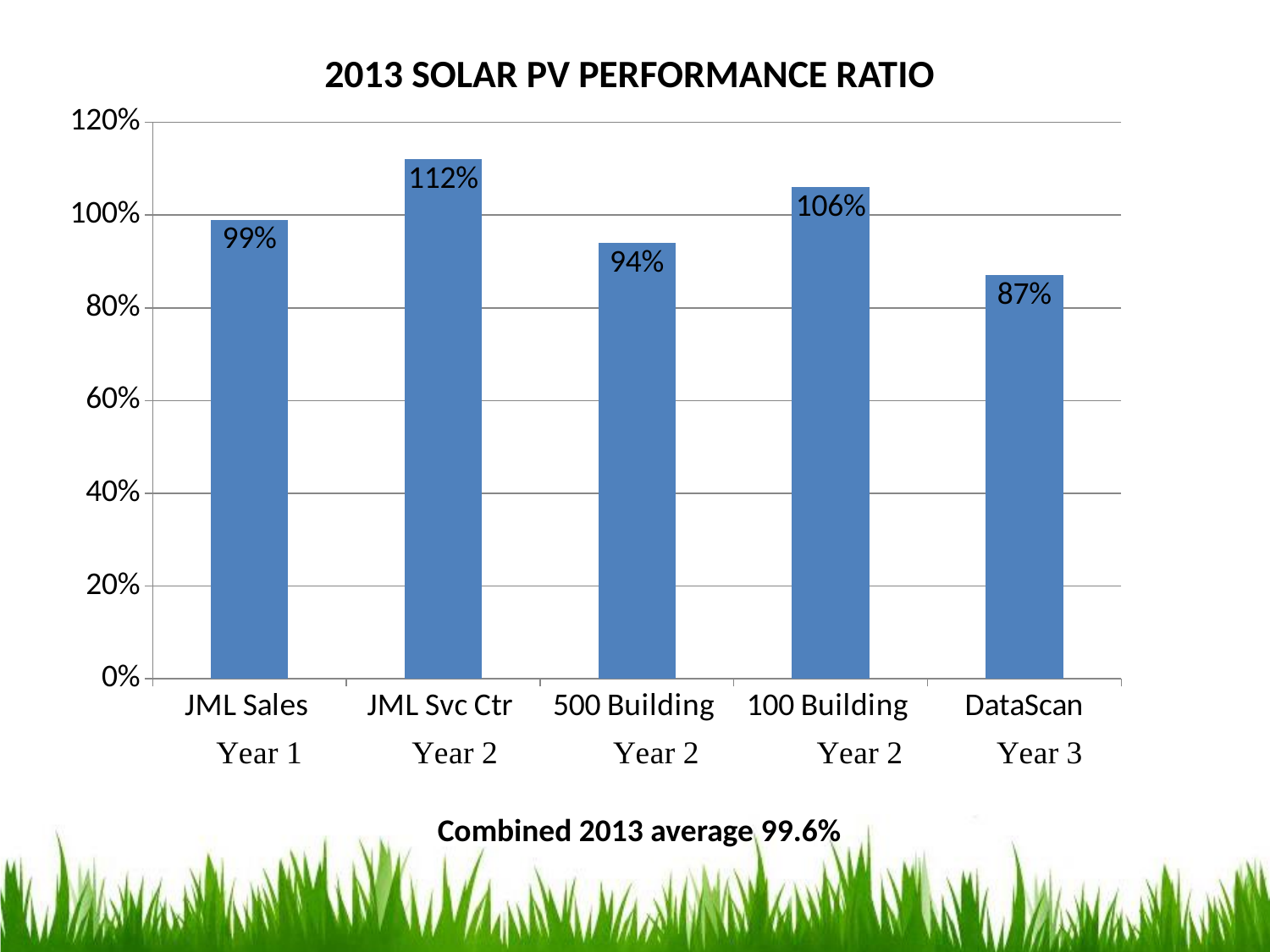
What is the performance ratio for 100 Building? 106% What is the title of the chart? 2013 SOLAR PV PERFORMANCE RATIO Which has a higher performance ratio, JML Sales or 100 Building? 100 Building What is the difference between the performance ratios of JML Svc Ctr and 500 Building? 18% Is the value for 500 Building greater or less than 100%? less What is the performance ratio for DataScan? 87% What kind of chart is shown on the slide? Bar chart Which site has the lowest performance ratio? DataScan What is the performance ratio for JML Sales? 99% How many sites are shown in the chart? 5 What is the combined 2013 average stated on the slide? 99.6% Which site has the highest performance ratio? JML Svc Ctr